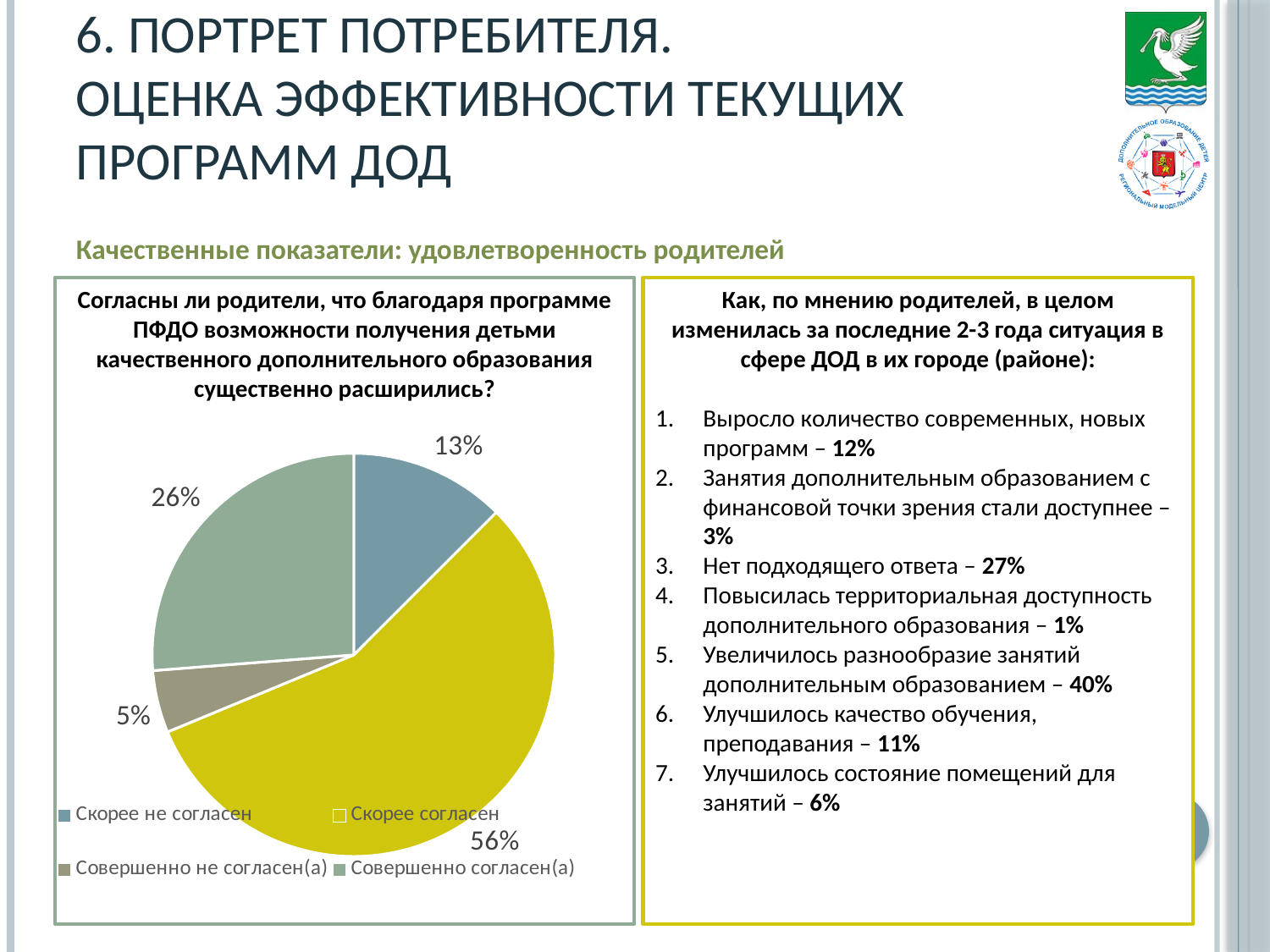
How many slices does the pie chart have? 4 What share of parents answered "Скорее не согласен" in the pie chart? 13% What share of parents answered "Совершенно согласен(а)" in the pie chart? 26% What share of parents answered "Совершенно не согласен(а)" in the pie chart? 5% Which answer has the largest slice in the pie chart? Скорее согласен What is the combined share of "Скорее согласен" and "Совершенно согласен(а)"? 82% What share of parents answered "Скорее согласен" in the pie chart? 56% What is the difference in percentage points between "Скорее согласен" and "Совершенно согласен(а)"? 30 Which is larger: the share for "Скорее не согласен" or for "Совершенно согласен(а)"? Совершенно согласен(а) What type of chart is shown on the slide? pie chart Which answer has the smallest slice in the pie chart? Совершенно не согласен(а) Which colour represents "Скорее согласен" in the pie chart? yellow